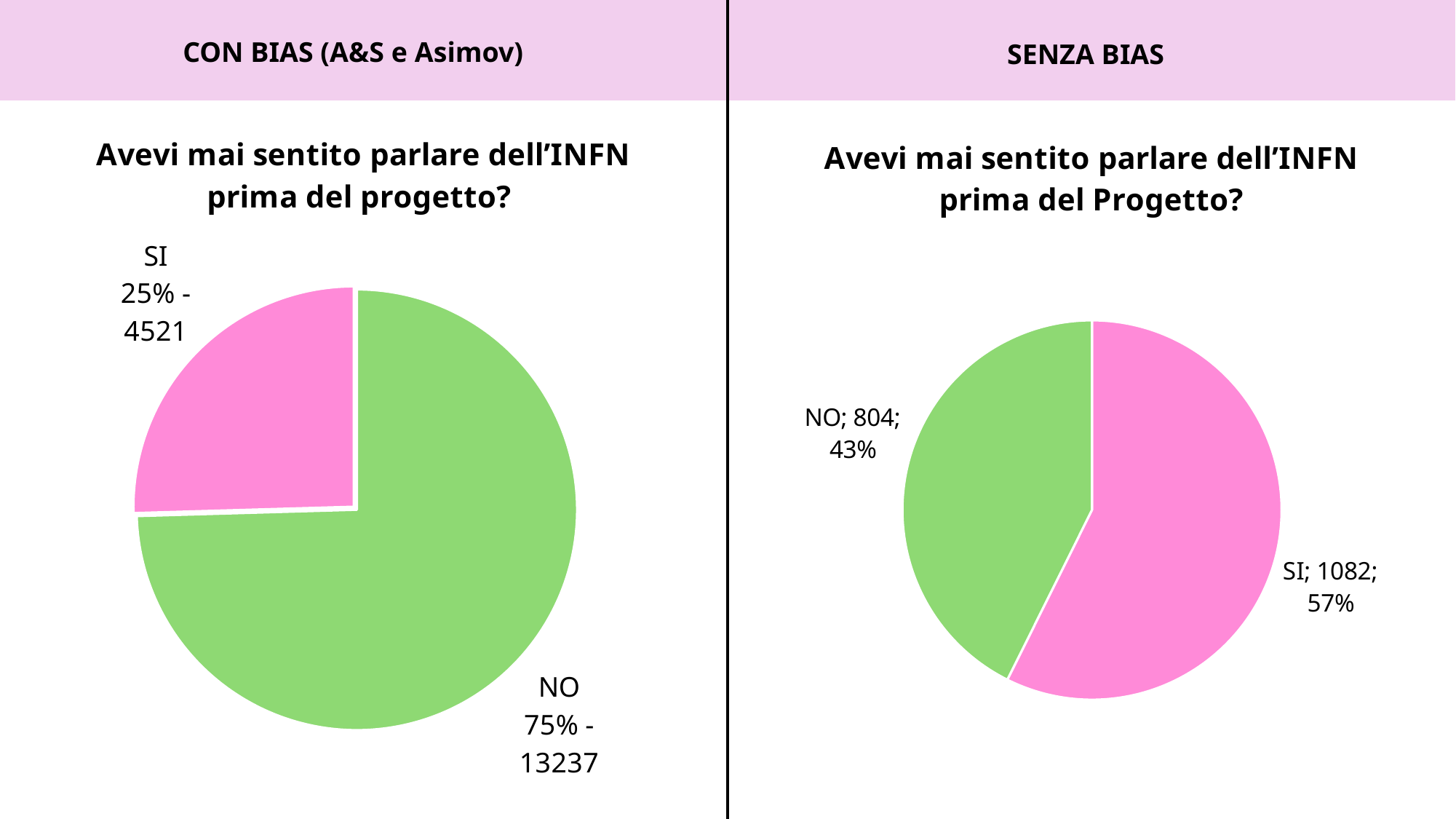
In the right chart (SENZA BIAS), what share of the pie is NO? 43% In the right chart (SENZA BIAS), which slice is the smallest? NO In the right chart (SENZA BIAS), what is the count for SI? 1082 In the left chart (CON BIAS), which slice is the largest? NO In the left chart (CON BIAS), what is the count for SI? 4521 In the left chart (CON BIAS), what share of the pie is NO? 75% In the left chart (CON BIAS), what is the count for NO? 13237 In the right chart (SENZA BIAS), how many slices does the pie have? 2 In the right chart (SENZA BIAS), what colour is the SI slice? pink In the left chart (CON BIAS), what is the difference between the NO count and the SI count? 8716 In the left chart (CON BIAS), what kind of chart is shown? pie chart In the right chart (SENZA BIAS), what is the difference between the SI count and the NO count? 278